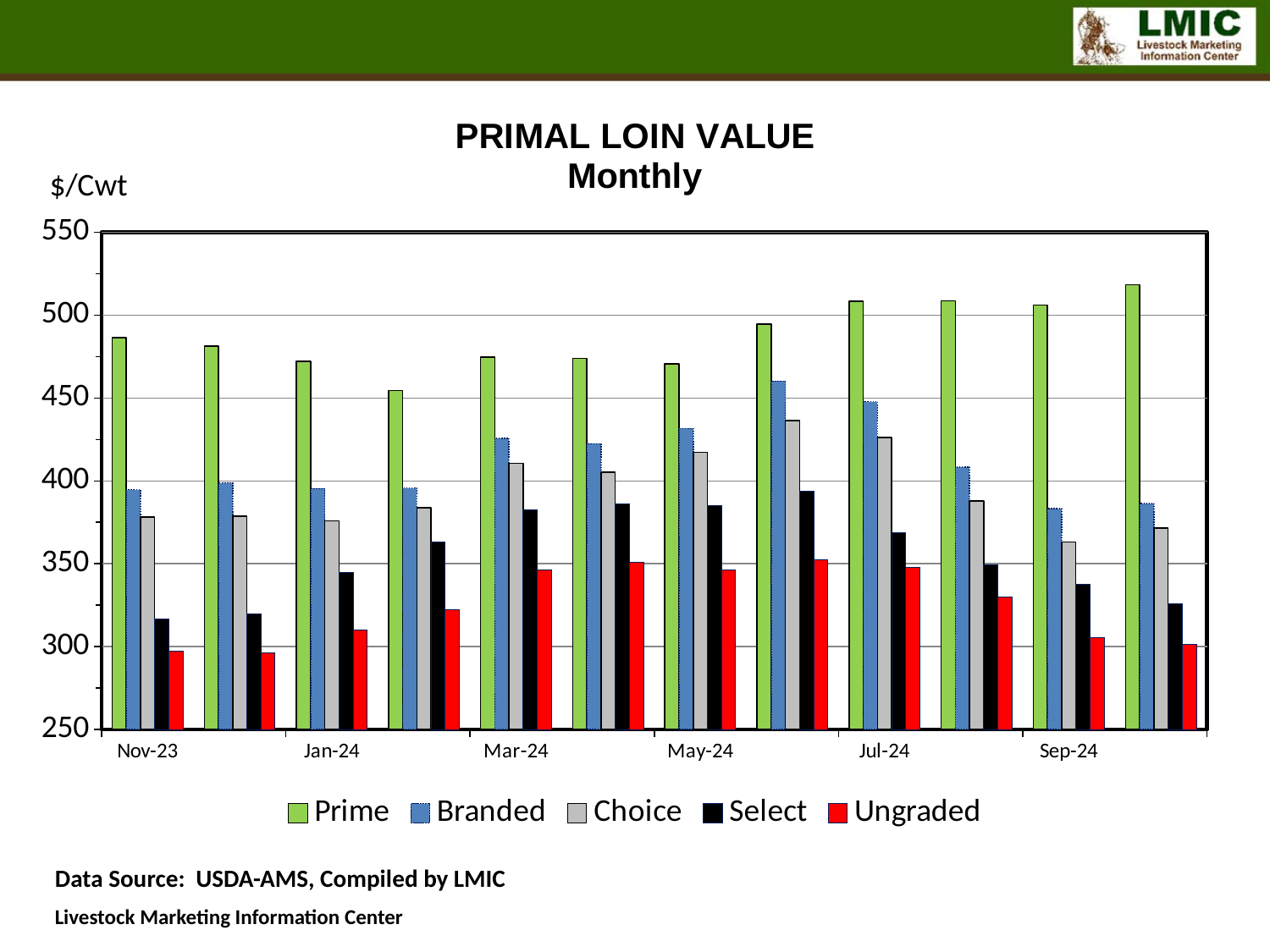
What unit is shown on the y axis of the chart? $/Cwt Is the Choice value for Jul-24 greater or less than 400? greater How many series does the legend list? 5 In May-24, which is larger, the Branded value or the Choice value? Branded What kind of chart is shown on the slide? bar chart Which is larger, the Choice value for Jan-24 or the Choice value for Mar-24? Mar-24 Is the Ungraded value for Nov-23 greater or less than 300? less Is the Select value for Sep-24 greater or less than 350? less How many monthly groups of bars are plotted in the chart? 12 Does the Prime value rise or fall from Nov-23 to Jan-24? fall